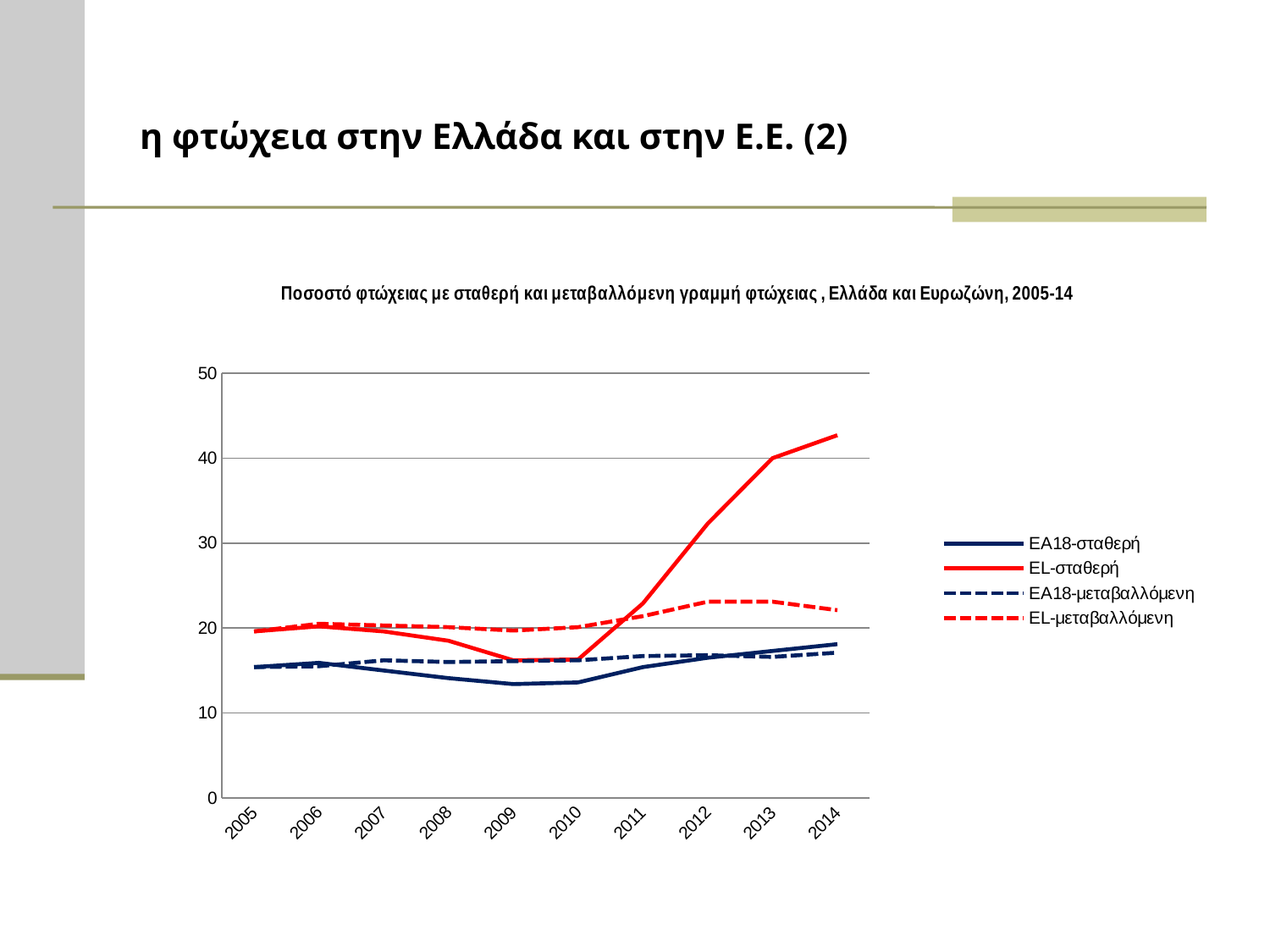
In 2010, which is larger: EL-σταθερή or EL-μεταβαλλόμενη? EL-μεταβαλλόμενη Is the value for EL-μεταβαλλόμενη in 2012 greater or less than 20? greater How many series does the legend list? 4 Does the EL-σταθερή series rise or fall from 2010 to 2014? rise Is the value for EL-σταθερή in 2012 greater or less than 30? greater How many years are shown on the x axis? 10 What is the title of the chart? Ποσοστό φτώχειας με σταθερή και μεταβαλλόμενη γραμμή φτώχειας , Ελλάδα και Ευρωζώνη, 2005-14 In which year does the EL-σταθερή series reach its highest value? 2014 In 2014, which is larger: EL-σταθερή or EA18-σταθερή? EL-σταθερή Is the value for EA18-σταθερή in 2009 greater or less than 20? less What kind of chart is shown on the slide? line chart